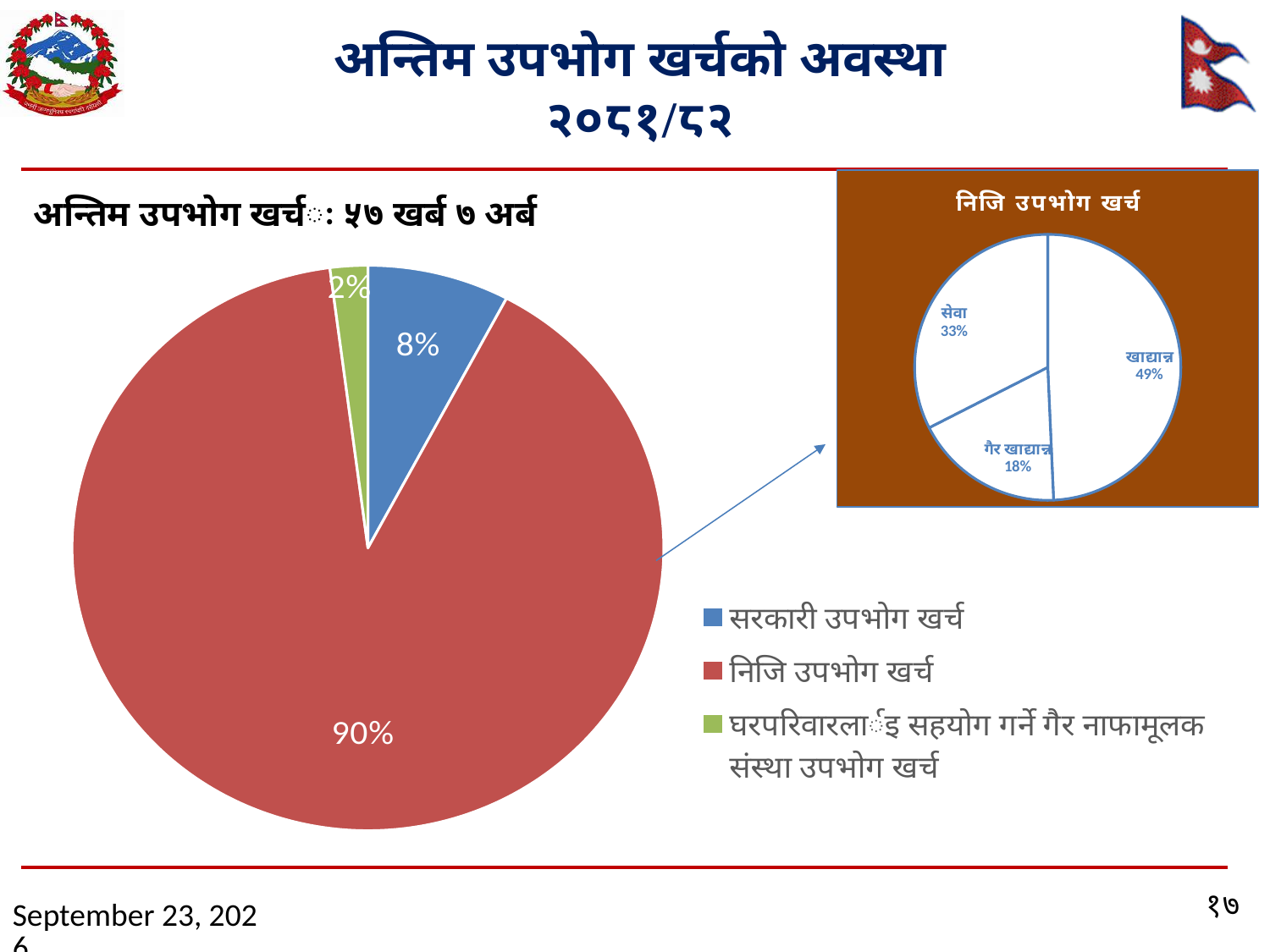
In the large pie chart on the left, what share is labelled for घरपरिवारलाई सहयोग गर्ने गैर नाफामूलक संस्था उपभोग खर्च? 2% In the large pie chart on the left, what share is labelled for सरकारी उपभोग खर्च? 8% What kind of chart is the chart titled निजि उपभोग खर्च on the right? pie chart In the chart titled निजि उपभोग खर्च, what share is labelled for सेवा? 33% In the large pie chart on the left, which category has the smallest slice? घरपरिवारलाई सहयोग गर्ने गैर नाफामूलक संस्था उपभोग खर्च In the large pie chart on the left, what share is labelled for निजि उपभोग खर्च? 90% In the large pie chart on the left, how many percentage points larger is निजि उपभोग खर्च than सरकारी उपभोग खर्च? 82 How many entries does the legend of the large pie chart on the left list? 3 In the chart titled निजि उपभोग खर्च, which category has the smallest slice? गैर खाद्यान्न In the large pie chart on the left, which category has the largest slice? निजि उपभोग खर्च In the chart titled निजि उपभोग खर्च, what share is labelled for खाद्यान्न? 49% In the chart titled निजि उपभोग खर्च, how many slices does the pie have? 3